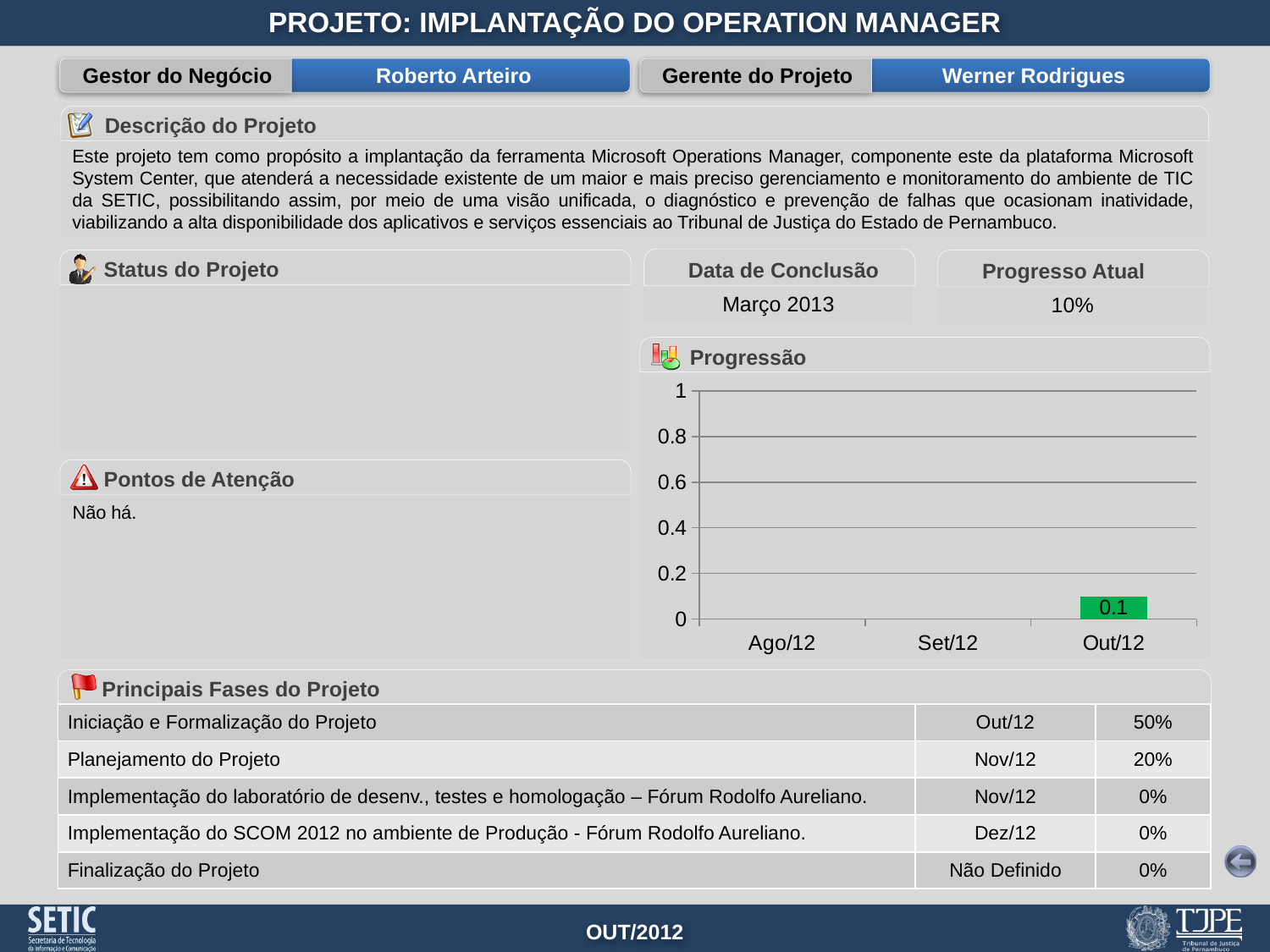
Which category in the Progressão chart is the only one with a visible bar? Out/12 What is the highest value shown on the y axis of the Progressão chart? 1 What colour is the bar for Out/12 in the Progressão chart? green Which category has the highest value in the Progressão chart? Out/12 Is the value for Out/12 in the Progressão chart greater or less than 0.2? less What is the value shown for Out/12 in the Progressão chart? 0.1 How many categories are shown on the x axis of the Progressão chart? 3 What kind of chart is the Progressão chart? bar chart What is the title of the chart on the slide? Progressão Is the value for Out/12 in the Progressão chart greater or less than 0.6? less Which is the first category on the x axis of the Progressão chart? Ago/12